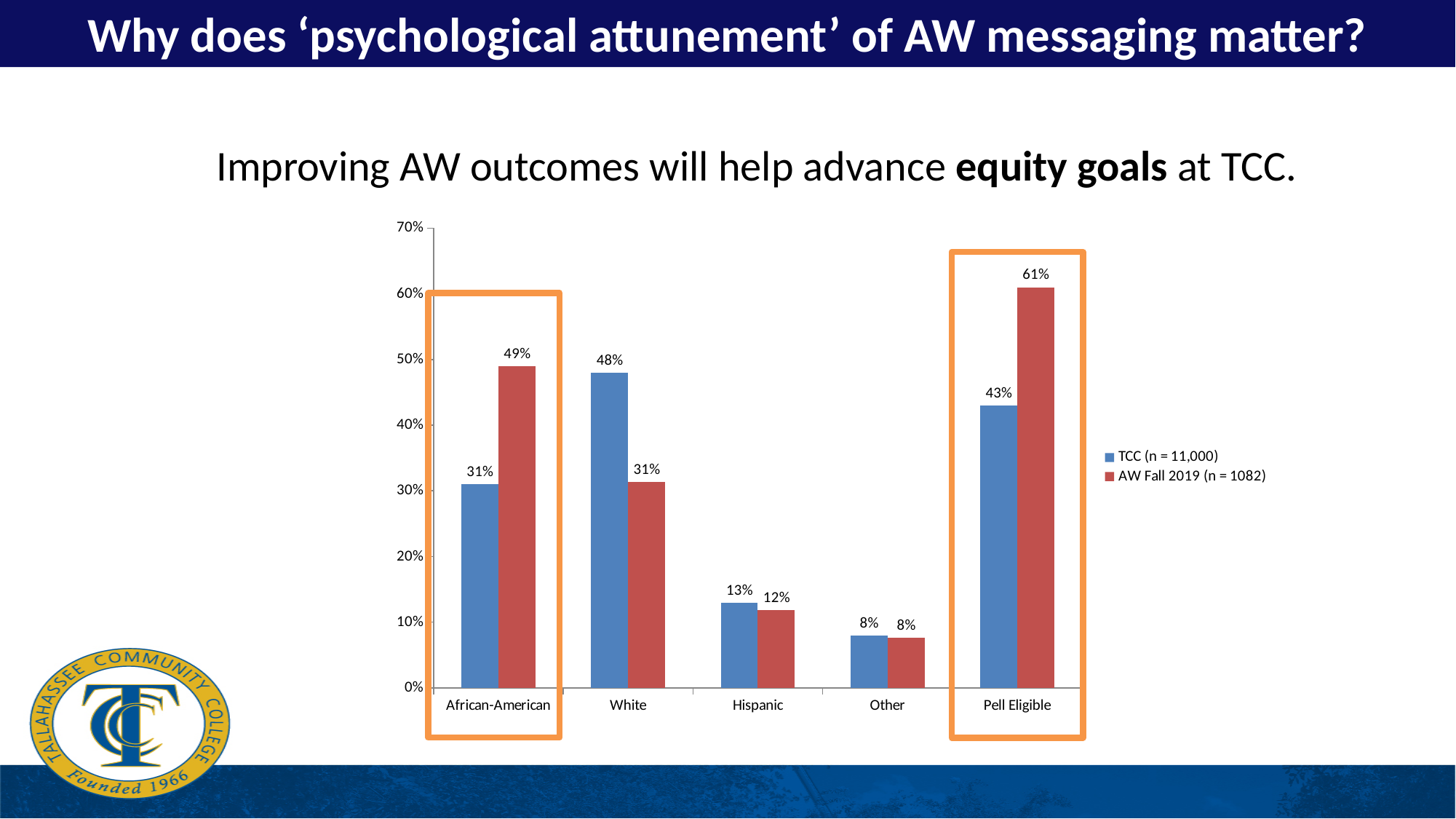
For Pell Eligible, which series has the larger value, TCC (n = 11,000) or AW Fall 2019 (n = 1082)? AW Fall 2019 (n = 1082) How many categories are shown on the x axis? 5 What is the AW Fall 2019 (n = 1082) value for Pell Eligible? 61% What is the difference between the TCC (n = 11,000) and AW Fall 2019 (n = 1082) values for White? 17% What is the difference between the AW Fall 2019 (n = 1082) and TCC (n = 11,000) values for African-American? 18% Which category has the highest TCC (n = 11,000) value? White Which colour represents the AW Fall 2019 (n = 1082) series? Red What is the TCC (n = 11,000) value for White? 48% What kind of chart is shown on the slide? Bar chart What is the AW Fall 2019 (n = 1082) value for African-American? 49% Which category has the lowest AW Fall 2019 (n = 1082) value? Other How many series does the legend list? 2